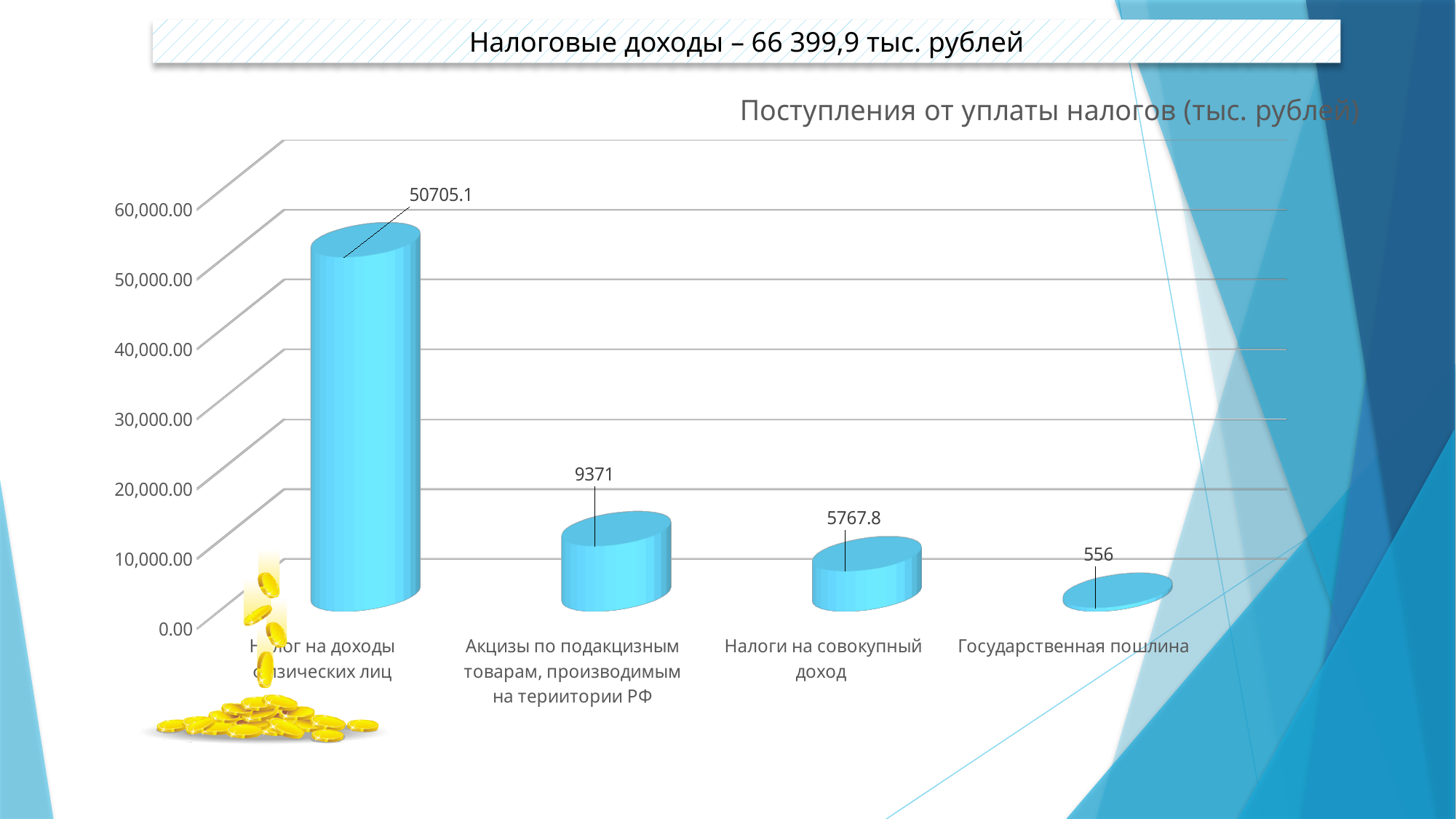
What is the difference between the values for Акцизы по подакцизным товарам, производимым на территории РФ and Налоги на совокупный доход? 3603.2 What is the difference between the values for Налог на доходы физических лиц and Государственная пошлина? 50149.1 Is the value for Налог на доходы физических лиц greater or less than 50,000.00? greater What is the value for Государственная пошлина? 556 What is the value for Налоги на совокупный доход? 5767.8 What is the title of the chart? Поступления от уплаты налогов (тыс. рублей) Which category has the lowest value? Государственная пошлина Which is larger, the value for Акцизы по подакцизным товарам, производимым на территории РФ or the value for Налоги на совокупный доход? Акцизы по подакцизным товарам, производимым на территории РФ What is the value for Налог на доходы физических лиц? 50705.1 How many categories are shown on the chart? 4 What is the value for Акцизы по подакцизным товарам, производимым на территории РФ? 9371 Which category has the highest value? Налог на доходы физических лиц